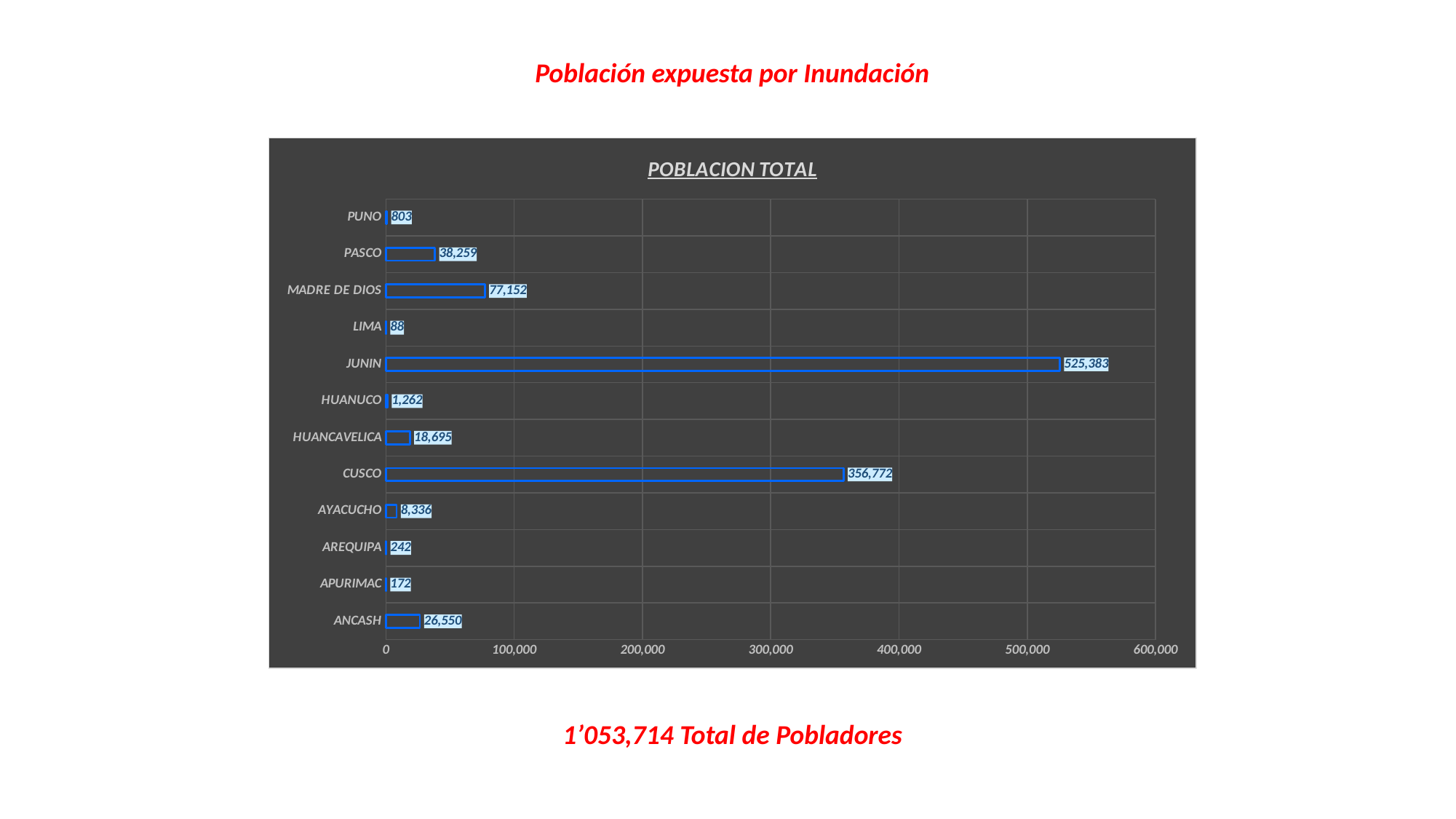
Is the value for CUSCO greater or less than 300,000? greater What is the value for ANCASH? 26,550 What is the title of the chart? POBLACION TOTAL How many categories are shown in the chart? 12 What is the value for MADRE DE DIOS? 77,152 What is the value for JUNIN? 525,383 What kind of chart is shown? bar chart Which category has the lowest value? LIMA Which is larger, the value for PASCO or the value for HUANCAVELICA? PASCO Which category has the highest value? JUNIN What is the value for CUSCO? 356,772 What is the difference between the values for JUNIN and CUSCO? 168,611